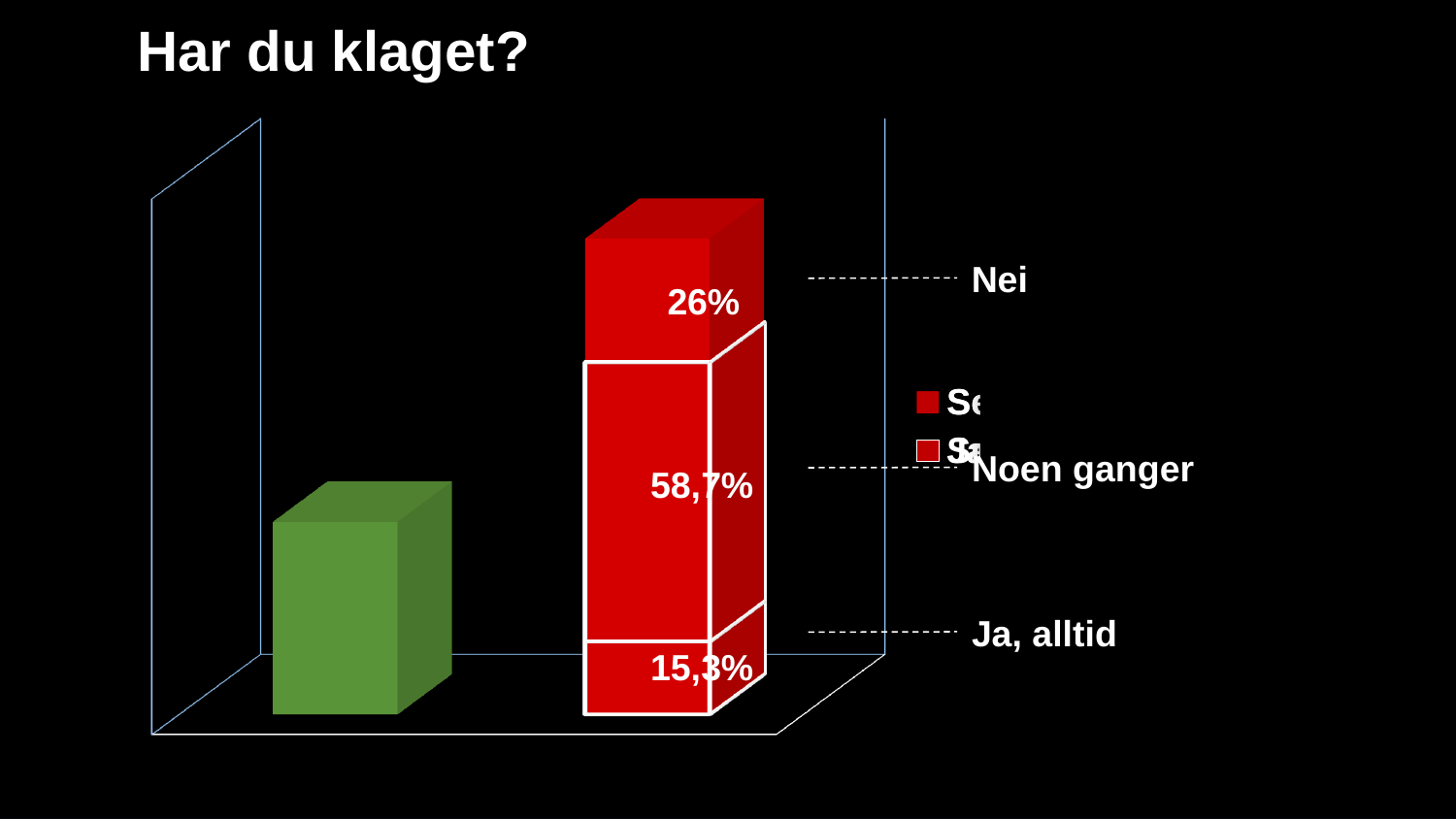
What value is printed on the bottom segment of the red stacked bar, labelled "Ja, alltid"? 15,3% How many bars are plotted in the chart? 2 Which segment of the red stacked bar has the smallest value? Ja, alltid (15,3%) Which is larger, the "Nei" segment or the "Ja, alltid" segment? Nei What is the title of the chart? Har du klaget? What kind of chart is shown on the slide? bar chart What is the difference between the "Nei" segment and the "Ja, alltid" segment? 10,7% What value is printed on the top segment of the red stacked bar, labelled "Nei"? 26% What is the difference between the "Noen ganger" segment and the "Ja, alltid" segment? 43,4% What is the total of the three segments in the red stacked bar? 100% Which segment of the red stacked bar has the largest value? Noen ganger (58,7%) What value is printed on the middle segment of the red stacked bar, labelled "Noen ganger"? 58,7%